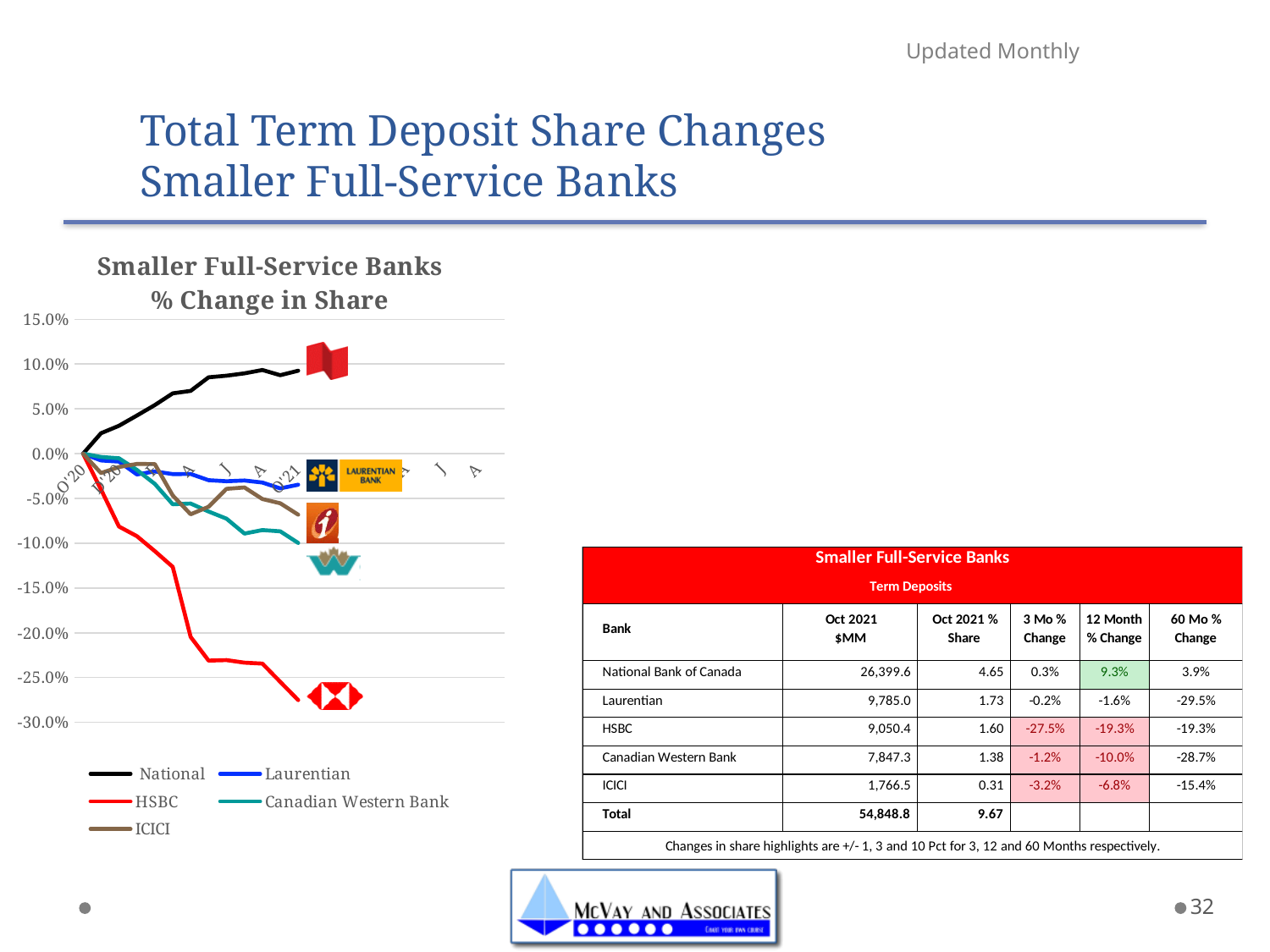
Is the final value for Canadian Western Bank greater or less than -5.0%? less Does the National line rise or fall over the period shown? rise Which series ends highest at the right end of the chart? National What is the title of the chart? Smaller Full-Service Banks % Change in Share Is the final value for HSBC greater or less than -25.0%? less Which series ends lowest at the right end of the chart? HSBC Is the final value for ICICI greater or less than -10.0%? greater What kind of chart is shown on the slide? line chart At the right end of the chart, which is higher: Laurentian or Canadian Western Bank? Laurentian What colour is the HSBC line in the chart? red How many series does the chart's legend list? 5